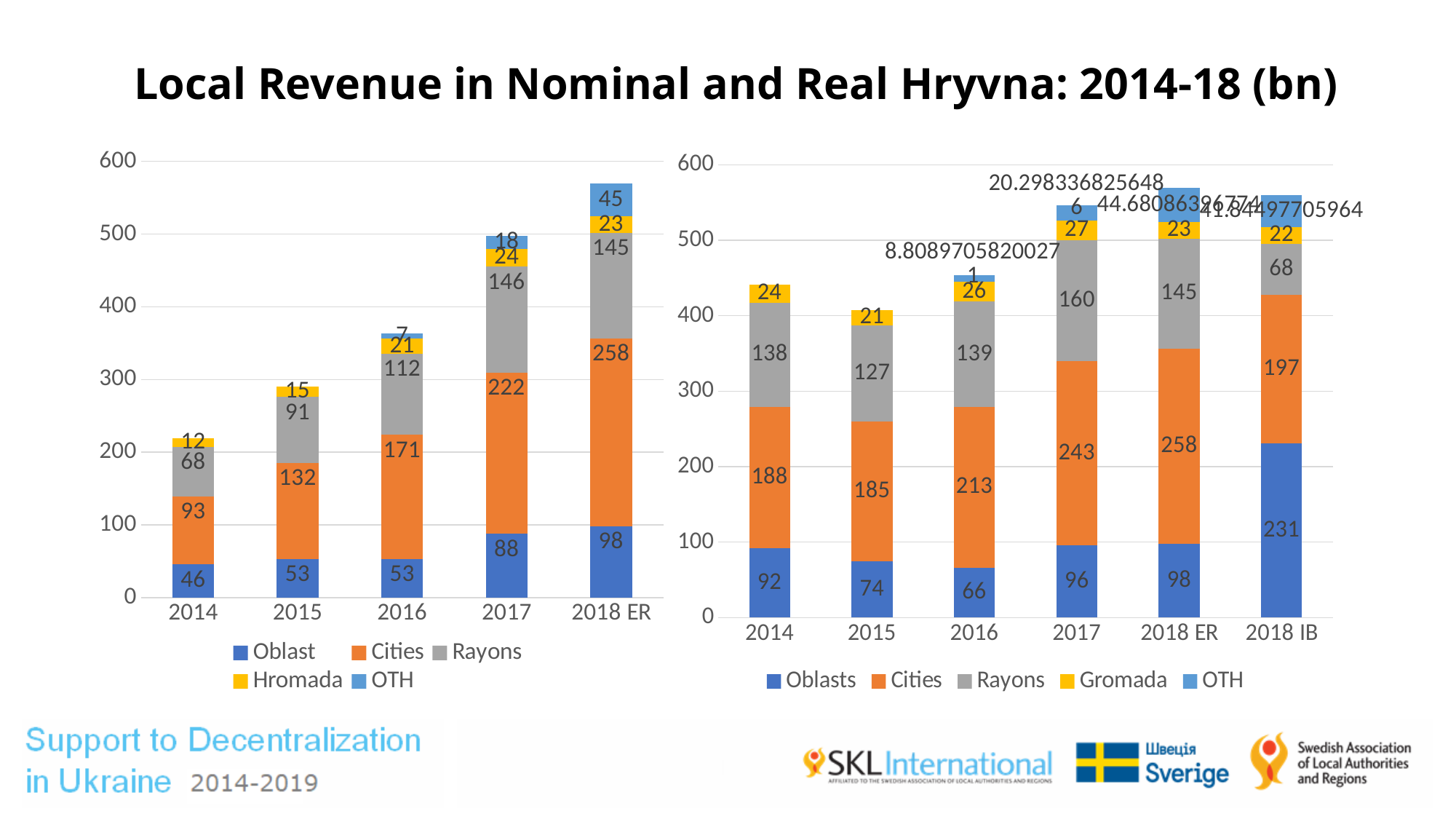
In the right chart, what is the value for Gromada in 2017? 27 In the left chart, is the total height of the 2017 bar greater or less than 400? greater In the right chart, is the Cities value larger in 2015 or in 2016? 2016 How many categories are shown on the x axis of the right chart? 6 In the left chart, what is the difference between the Cities value in 2018 ER and in 2014? 165 What kind of chart is the left chart? Stacked bar chart In the right chart, which category has the lowest Rayons value? 2018 IB In the right chart, what is the value for Oblasts in 2018 IB? 231 In the left chart, which year has the highest Oblast value? 2018 ER In the left chart, what is the value for Cities in 2017? 222 How many series does the legend of the left chart list? 5 In the left chart, what is the total of the stacked bar for 2018 ER? 569